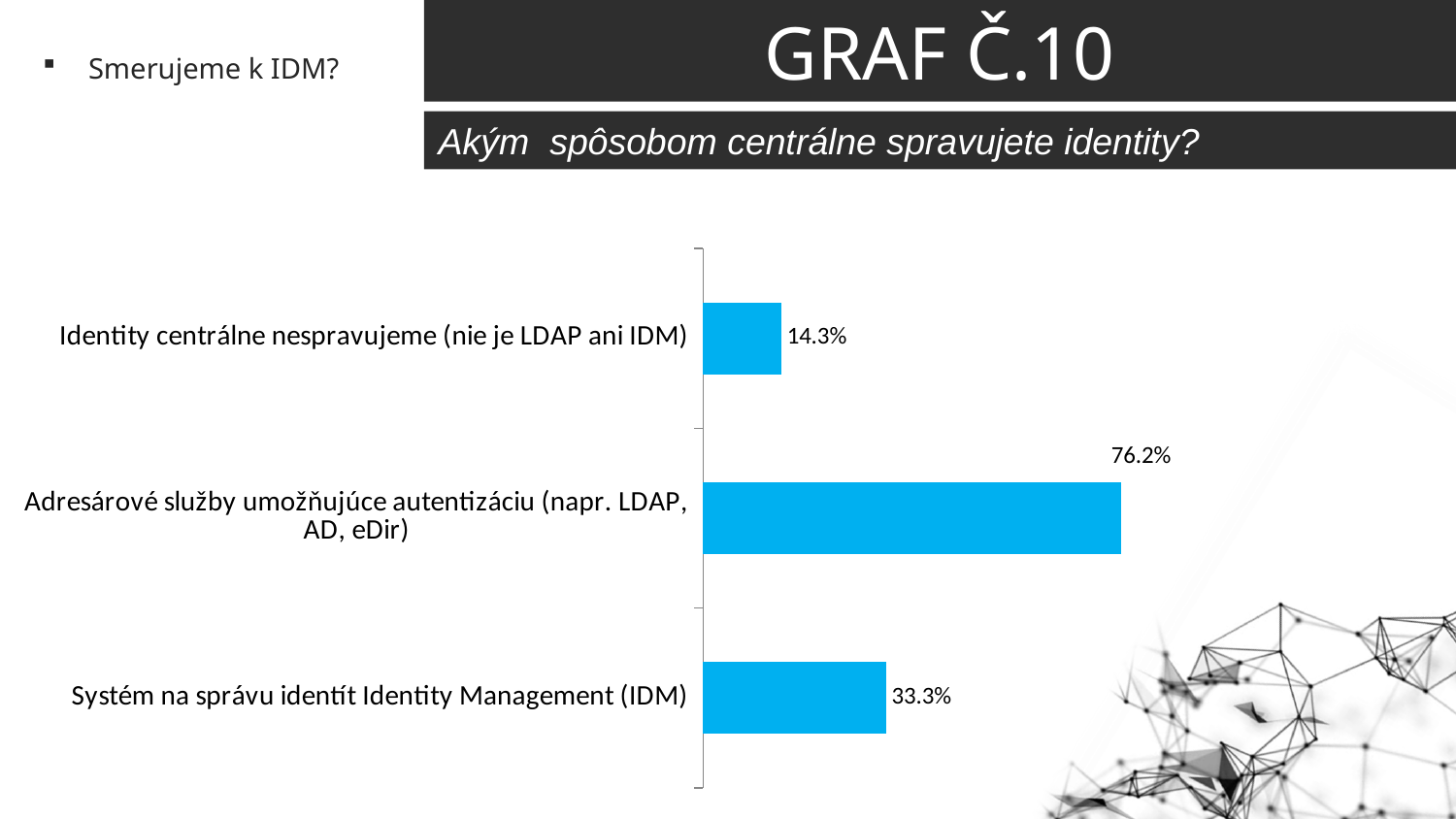
What is the difference between the value for 'Systém na správu identít Identity Management (IDM)' and the value for 'Identity centrálne nespravujeme (nie je LDAP ani IDM)'? 19.0% What is the value for 'Systém na správu identít Identity Management (IDM)'? 33.3% What kind of chart is shown on the slide? Bar chart What is the title of the chart? GRAF Č.10 Which is larger: the value for 'Systém na správu identít Identity Management (IDM)' or the value for 'Identity centrálne nespravujeme (nie je LDAP ani IDM)'? Systém na správu identít Identity Management (IDM) What question does the chart's subtitle ask? Akým spôsobom centrálne spravujete identity? What is the value for 'Adresárové služby umožňujúce autentizáciu (napr. LDAP, AD, eDir)'? 76.2% What is the difference between the value for 'Adresárové služby umožňujúce autentizáciu (napr. LDAP, AD, eDir)' and the value for 'Systém na správu identít Identity Management (IDM)'? 42.9% What is the value for 'Identity centrálne nespravujeme (nie je LDAP ani IDM)'? 14.3% How many categories are shown in the chart? 3 Which category has the lowest value? Identity centrálne nespravujeme (nie je LDAP ani IDM) Which category has the highest value? Adresárové služby umožňujúce autentizáciu (napr. LDAP, AD, eDir)